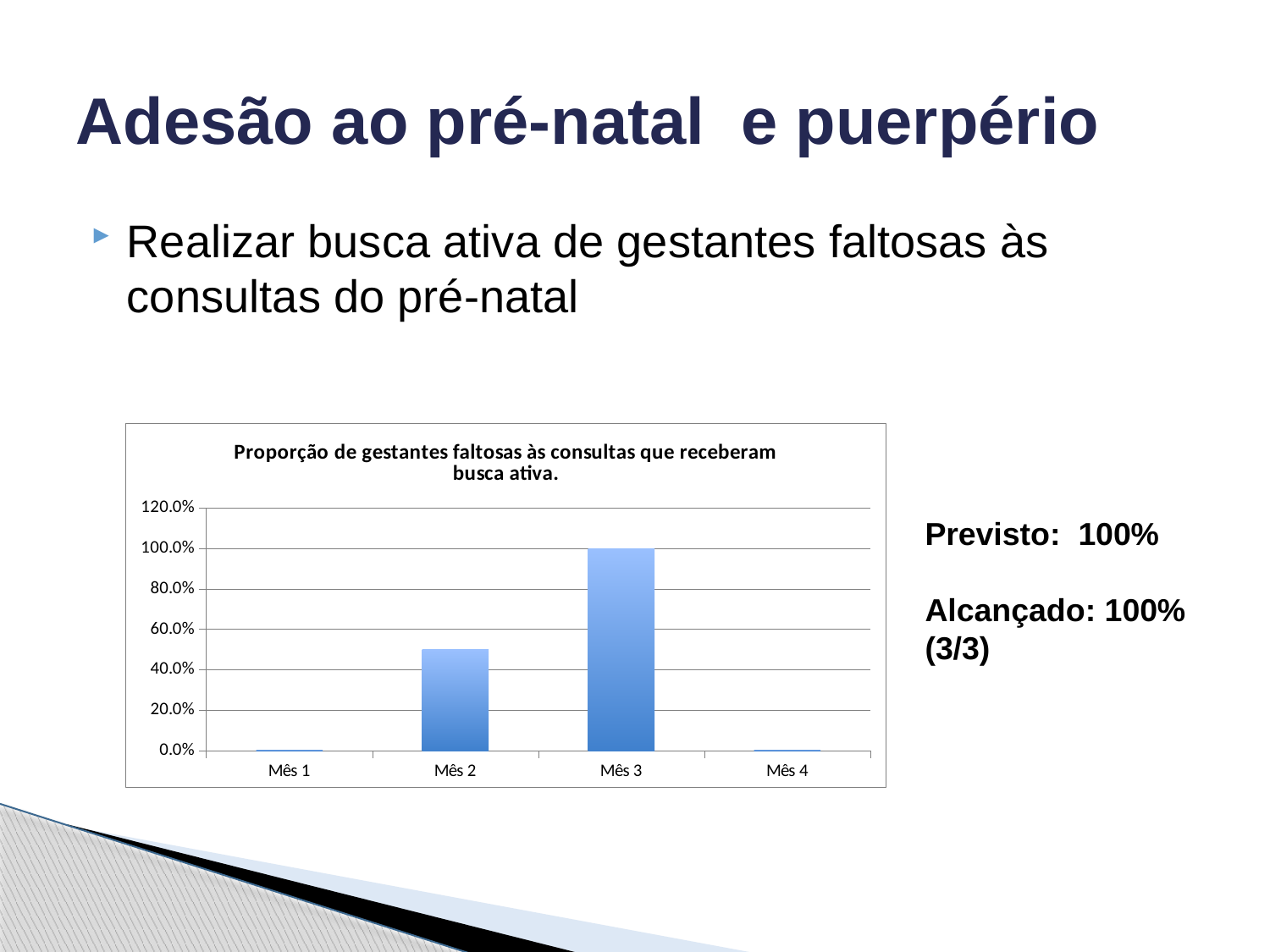
Which is larger, the value for Mês 2 or the value for Mês 3? Mês 3 What is the value for Mês 3 in the chart? 100.0% Is the value for Mês 1 greater or less than 20.0%? less What is the title of the chart? Proporção de gestantes faltosas às consultas que receberam busca ativa. Do the values rise or fall from Mês 1 to Mês 3? rise Is the value for Mês 4 greater or less than 20.0%? less Which month has the highest value in the chart? Mês 3 Is the value for Mês 2 greater or less than 40.0%? greater How many categories are shown on the x axis of the chart? 4 What kind of chart is shown on the slide? bar chart What is the highest tick value shown on the y axis of the chart? 120.0%